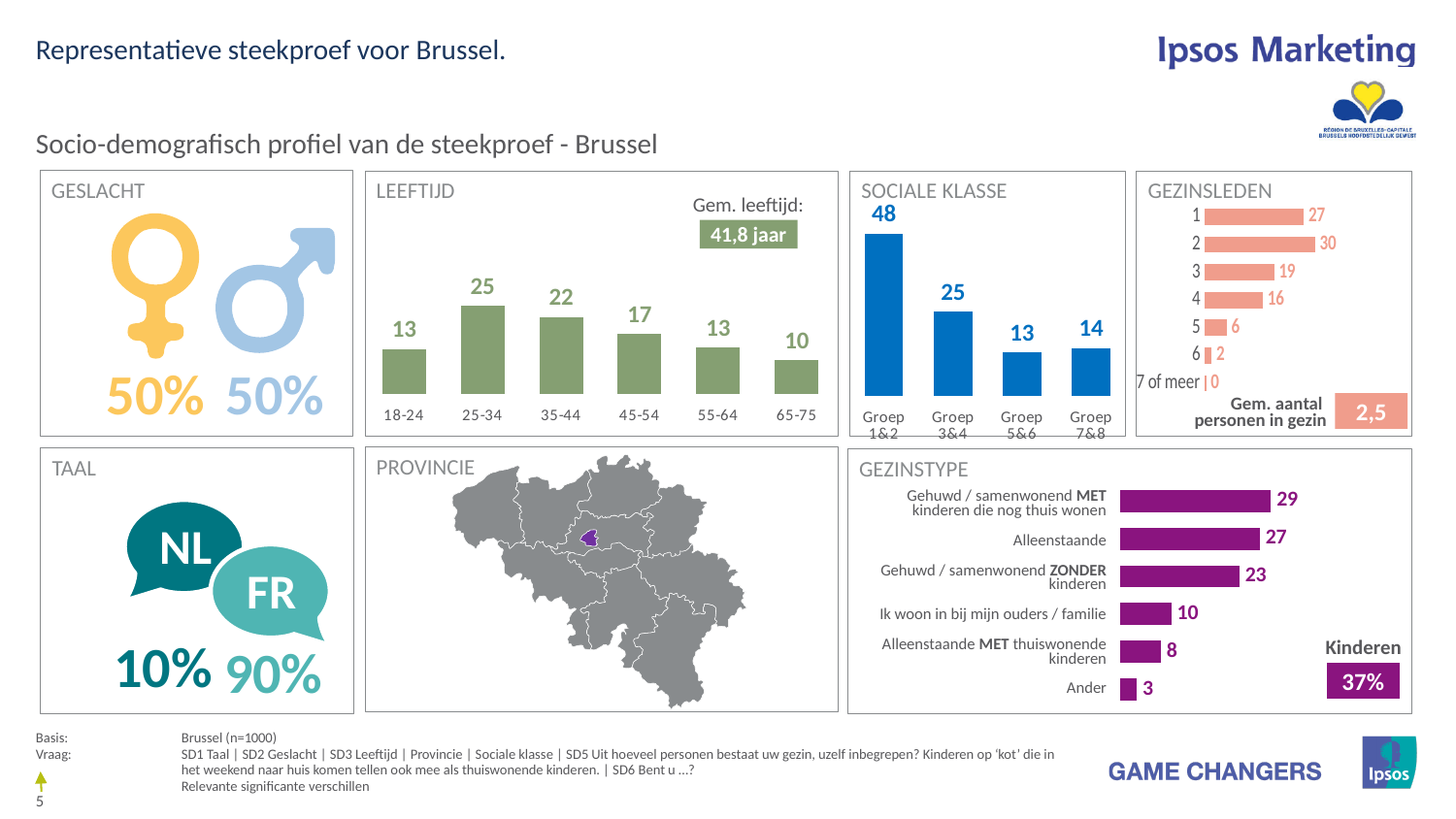
In the LEEFTIJD chart, which age group has the lowest value? 65-75 In the LEEFTIJD chart, what is the value for the 25-34 age group? 25 In the SOCIALE KLASSE chart, what kind of chart is used? Bar chart In the GEZINSTYPE chart, which category has the lowest value? Ander In the LEEFTIJD chart, how many age groups are shown? 6 In the SOCIALE KLASSE chart, which group has the highest value? Groep 1&2 In the SOCIALE KLASSE chart, what is the value for Groep 7&8? 14 In the GEZINSLEDEN chart, which household size has the highest value? 2 In the LEEFTIJD chart, what is the difference between the values for 25-34 and 45-54? 8 In the GEZINSTYPE chart, what is the value for Alleenstaande? 27 In the GEZINSLEDEN chart, what is the value for households of 4 persons? 16 In the GEZINSTYPE chart, which is larger: Gehuwd / samenwonend ZONDER kinderen or Ik woon in bij mijn ouders / familie? Gehuwd / samenwonend ZONDER kinderen